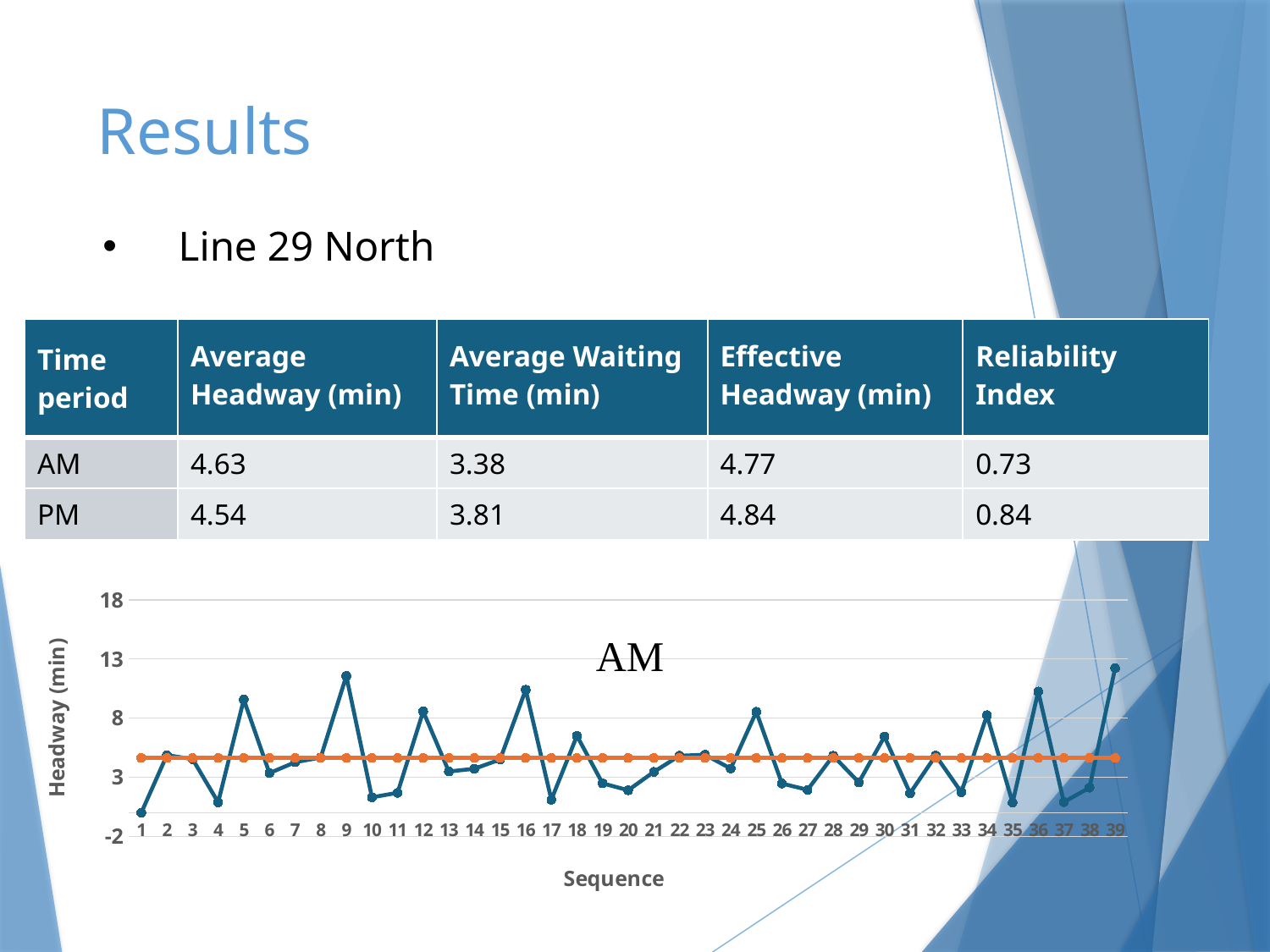
Is the headway value at sequence 1 greater or less than 3? less Which has the larger headway value, sequence 5 or sequence 6? sequence 5 Does the orange line rise, fall, or stay flat across the sequence? stays flat Is the headway value at sequence 16 greater or less than 8? greater Which has the larger headway value, sequence 9 or sequence 10? sequence 9 What kind of chart is shown on the slide? line chart What is the label of the y axis of the chart? Headway (min) How many sequence points are plotted along the x axis of the chart? 39 What is the title of the chart? AM Is the headway value at sequence 20 greater or less than 3? less